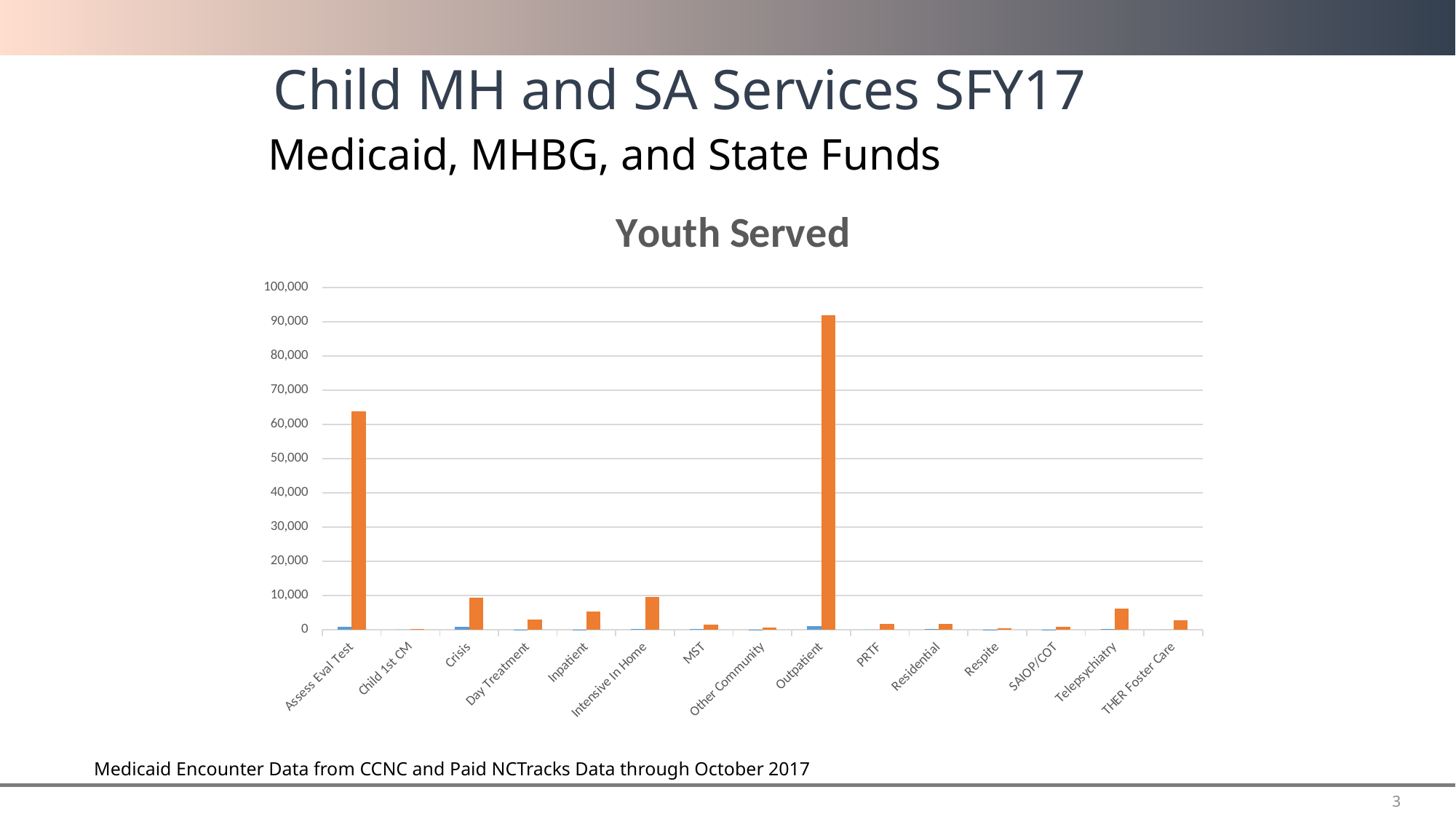
What is the title of the chart? Youth Served Which has the larger orange bar, Intensive In Home or Inpatient? Intensive In Home Is the orange bar for Assess Eval Test greater or less than 60,000? greater How many service categories are shown on the x axis of the chart? 15 Which category has the tallest orange bar in the Youth Served chart? Outpatient Is the orange bar for Telepsychiatry greater or less than 10,000? less Is the orange bar for Outpatient greater or less than 80,000? greater What is the highest value shown on the y axis of the chart? 100,000 What kind of chart is shown on the slide? bar chart Which has the larger orange bar, Assess Eval Test or Outpatient? Outpatient Which has the larger orange bar, Crisis or Day Treatment? Crisis